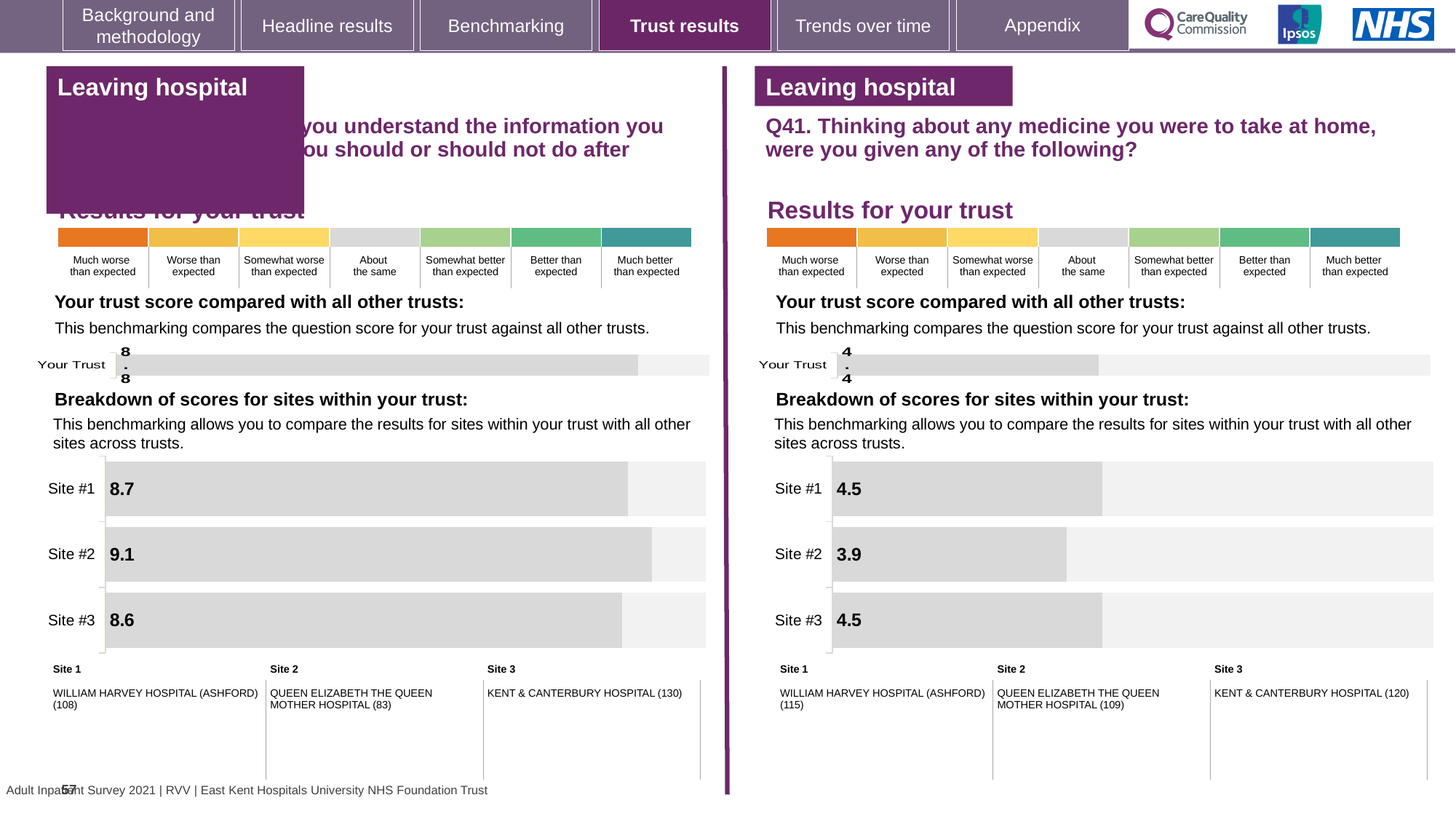
How many sites are shown on the Q41 site breakdown chart on the right? 3 On the left-hand site breakdown chart, which site has the highest score? Site #2 On the Q41 site breakdown chart on the right, is the score for Site #1 larger or smaller than the score for Site #2? larger On the Q41 site breakdown chart on the right, what is the score for Site #2? 3.9 On the left-hand 'Your trust score compared with all other trusts' chart, what is the score for Your Trust? 8.8 On the left-hand site breakdown chart, which site has the lowest score? Site #3 What type of chart is used for the site breakdown on the left-hand side of the slide? Bar chart On the Q41 site breakdown chart on the right, what is the difference between the scores for Site #1 and Site #2? 0.6 On the Q41 site breakdown chart on the right, which site has the lowest score? Site #2 On the left-hand site breakdown chart, what is the score for Site #2? 9.1 On the Q41 'Your trust score compared with all other trusts' chart on the right, what is the score for Your Trust? 4.4 On the left-hand site breakdown chart, what is the difference between the scores for Site #2 and Site #3? 0.5